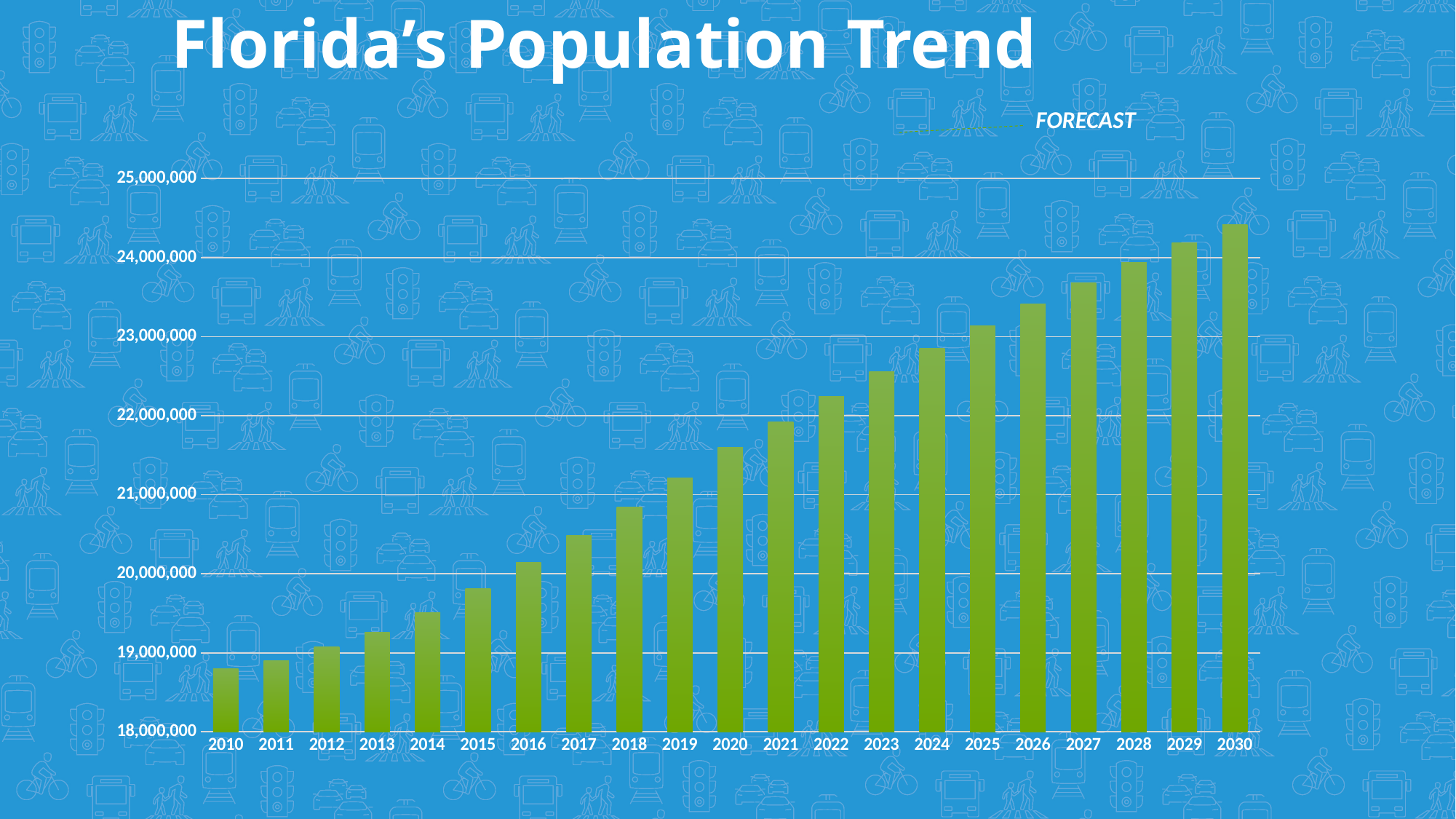
How many years are shown on the x axis of the chart? 21 What is the title of the chart? Florida's Population Trend What label appears in the legend above the chart? FORECAST Is the value for 2030 greater or less than 24,000,000? greater Is the value for 2015 greater or less than 20,000,000? less What kind of chart is shown on the slide? bar chart Is the value for 2020 greater or less than 21,000,000? greater Which year has the lowest bar in the chart? 2010 Do the values rise or fall from 2010 to 2030? rise Which year has the highest bar in the chart? 2030 Which year has the larger value, 2010 or 2025? 2025